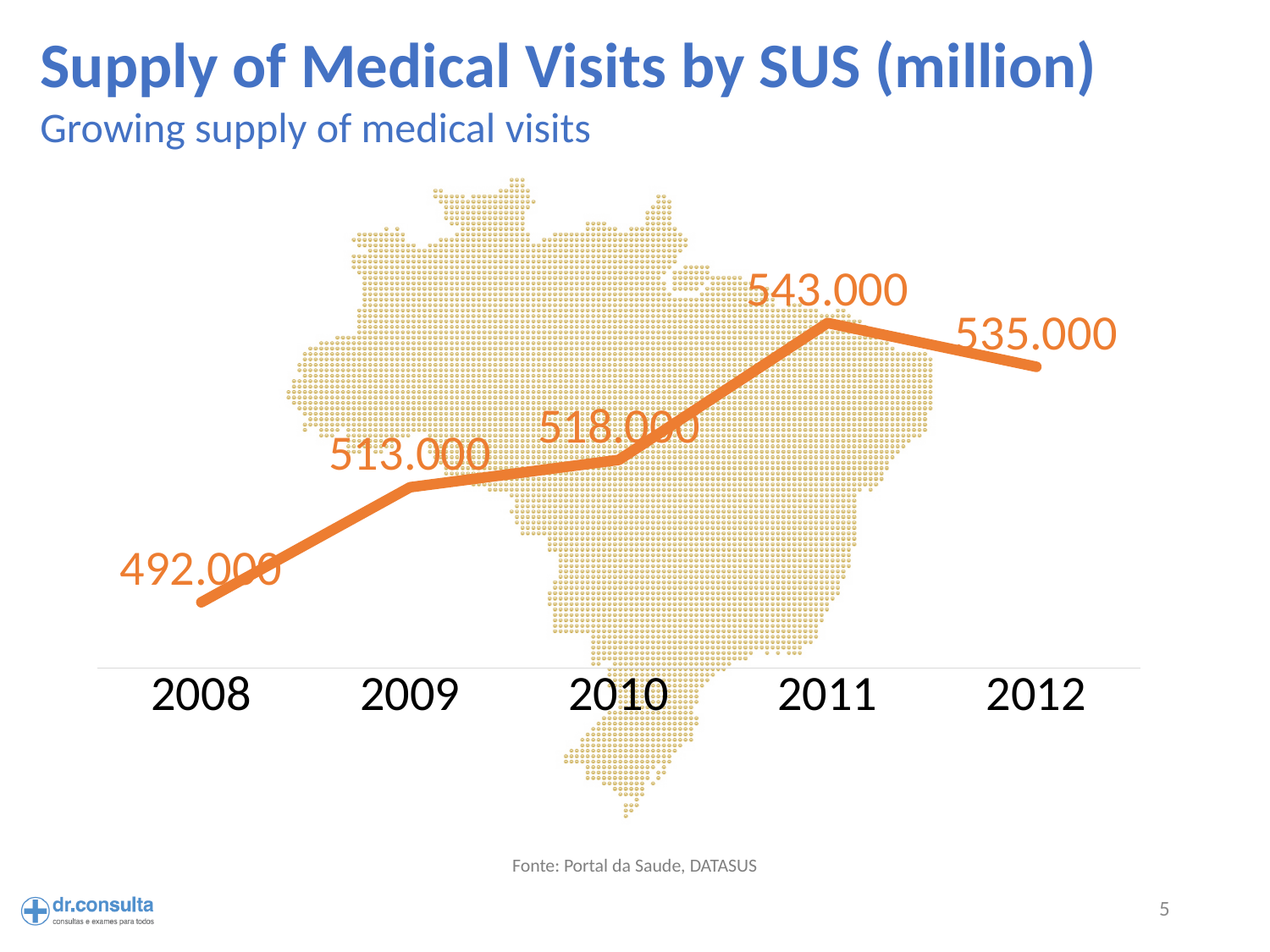
What is the difference between the values for 2011 and 2012? 8.000 Which year has the highest value? 2011 Do the values rise or fall from 2008 to 2011? rise What is the source cited below the chart? Portal da Saude, DATASUS What is the value for 2008? 492.000 How many years are plotted on the chart? 5 What is the value for 2012? 535.000 Which year has the lowest value? 2008 What kind of chart is shown on the slide? line chart Which is larger, the value for 2010 or the value for 2012? 2012 What is the value for 2011? 543.000 What is the difference between the values for 2008 and 2009? 21.000